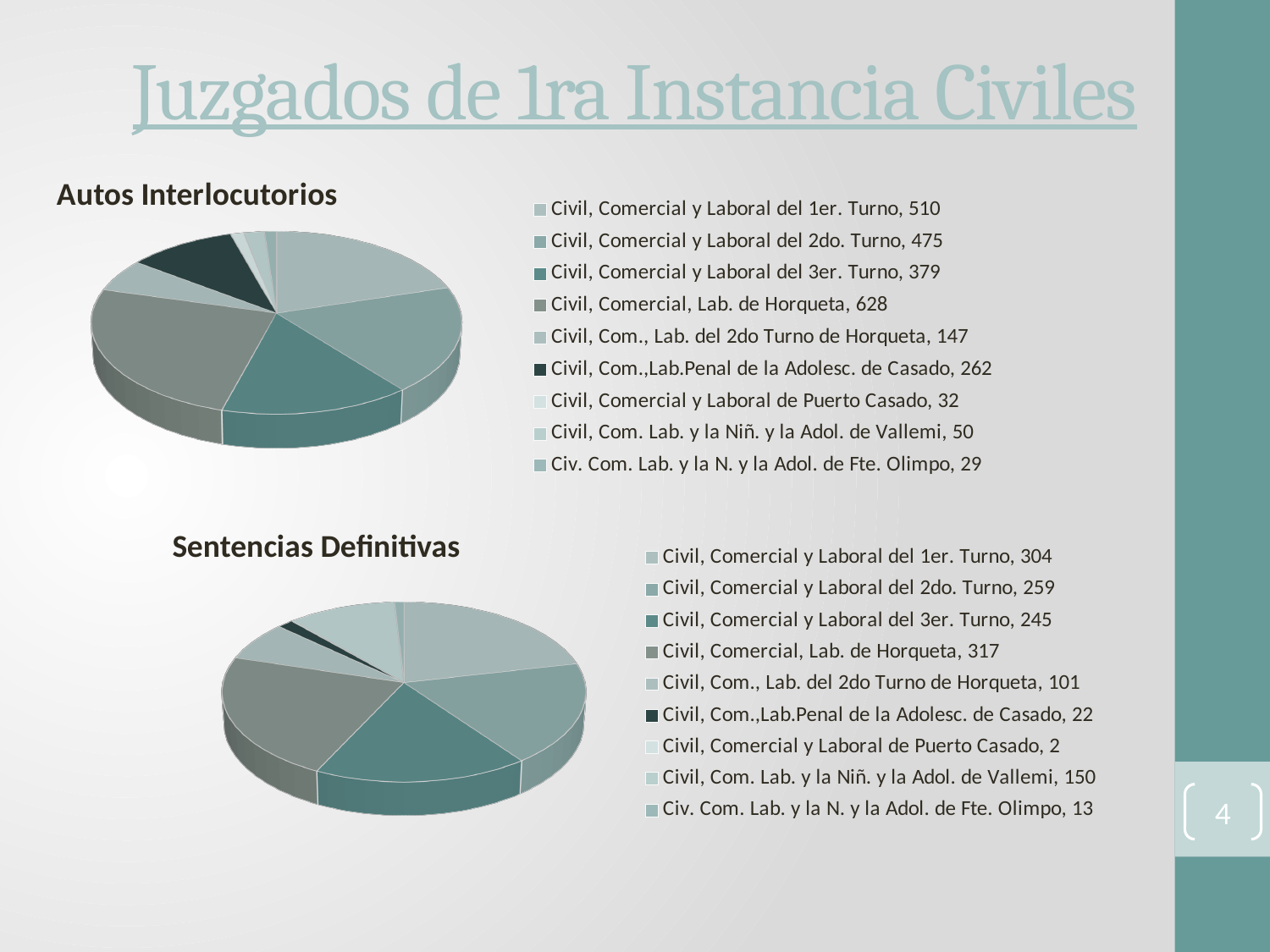
In the Autos Interlocutorios chart, which category has the lowest value? Civ. Com. Lab. y la N. y la Adol. de Fte. Olimpo In the Autos Interlocutorios chart, what is the value for Civil, Comercial, Lab. de Horqueta? 628 In the Sentencias Definitivas chart, which is larger: Civil, Comercial y Laboral del 2do. Turno or Civil, Comercial y Laboral del 3er. Turno? Civil, Comercial y Laboral del 2do. Turno In the Sentencias Definitivas chart, what is the difference between Civil, Comercial, Lab. de Horqueta and Civil, Comercial y Laboral del 1er. Turno? 13 In the Autos Interlocutorios chart, which category has the highest value? Civil, Comercial, Lab. de Horqueta In the Autos Interlocutorios chart, what is the difference between Civil, Comercial y Laboral del 1er. Turno and Civil, Comercial y Laboral del 2do. Turno? 35 In the Autos Interlocutorios chart, what is the total of all the values shown? 2512 How many categories does the Sentencias Definitivas chart show? 9 In the Sentencias Definitivas chart, which category has the lowest value? Civil, Comercial y Laboral de Puerto Casado What kind of chart is the Autos Interlocutorios chart? Pie chart In the Autos Interlocutorios chart, what share of the total does Civil, Comercial, Lab. de Horqueta represent? 25% In the Sentencias Definitivas chart, what is the value for Civil, Com. Lab. y la Niñ. y la Adol. de Vallemi? 150